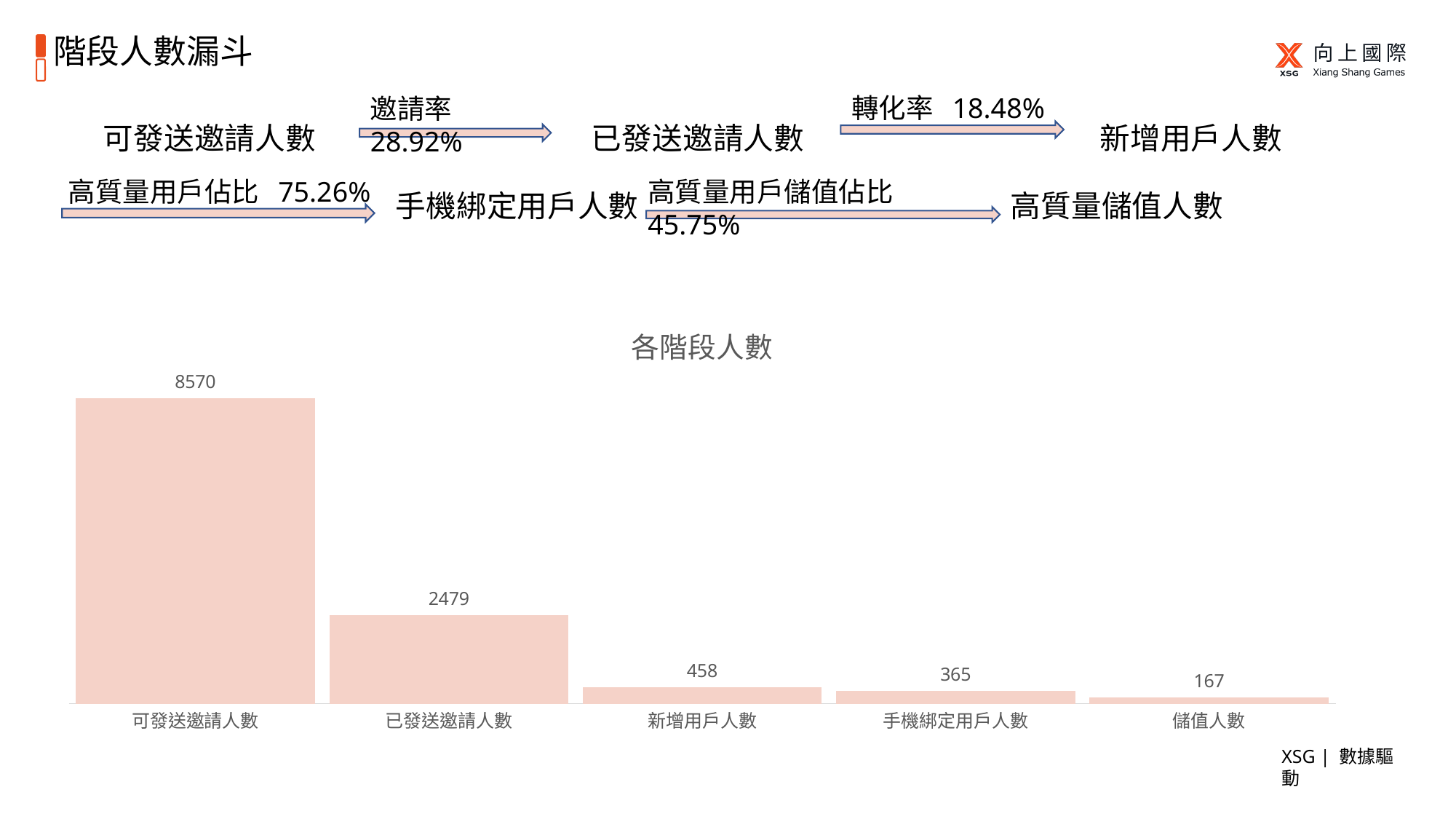
What is the value for 已發送邀請人數 in the 各階段人數 chart? 2479 What is the difference between 可發送邀請人數 and 已發送邀請人數 in the 各階段人數 chart? 6091 What is the value for 手機綁定用戶人數 in the 各階段人數 chart? 365 Which category has the highest value in the 各階段人數 chart? 可發送邀請人數 What is the value for 新增用戶人數 in the 各階段人數 chart? 458 How many categories are shown in the 各階段人數 chart? 5 What is the difference between 新增用戶人數 and 手機綁定用戶人數 in the 各階段人數 chart? 93 What kind of chart is the 各階段人數 chart? bar chart What is the value for 儲值人數 in the 各階段人數 chart? 167 Which category has the lowest value in the 各階段人數 chart? 儲值人數 What is the value for 可發送邀請人數 in the 各階段人數 chart? 8570 Which is larger in the 各階段人數 chart, 手機綁定用戶人數 or 儲值人數? 手機綁定用戶人數